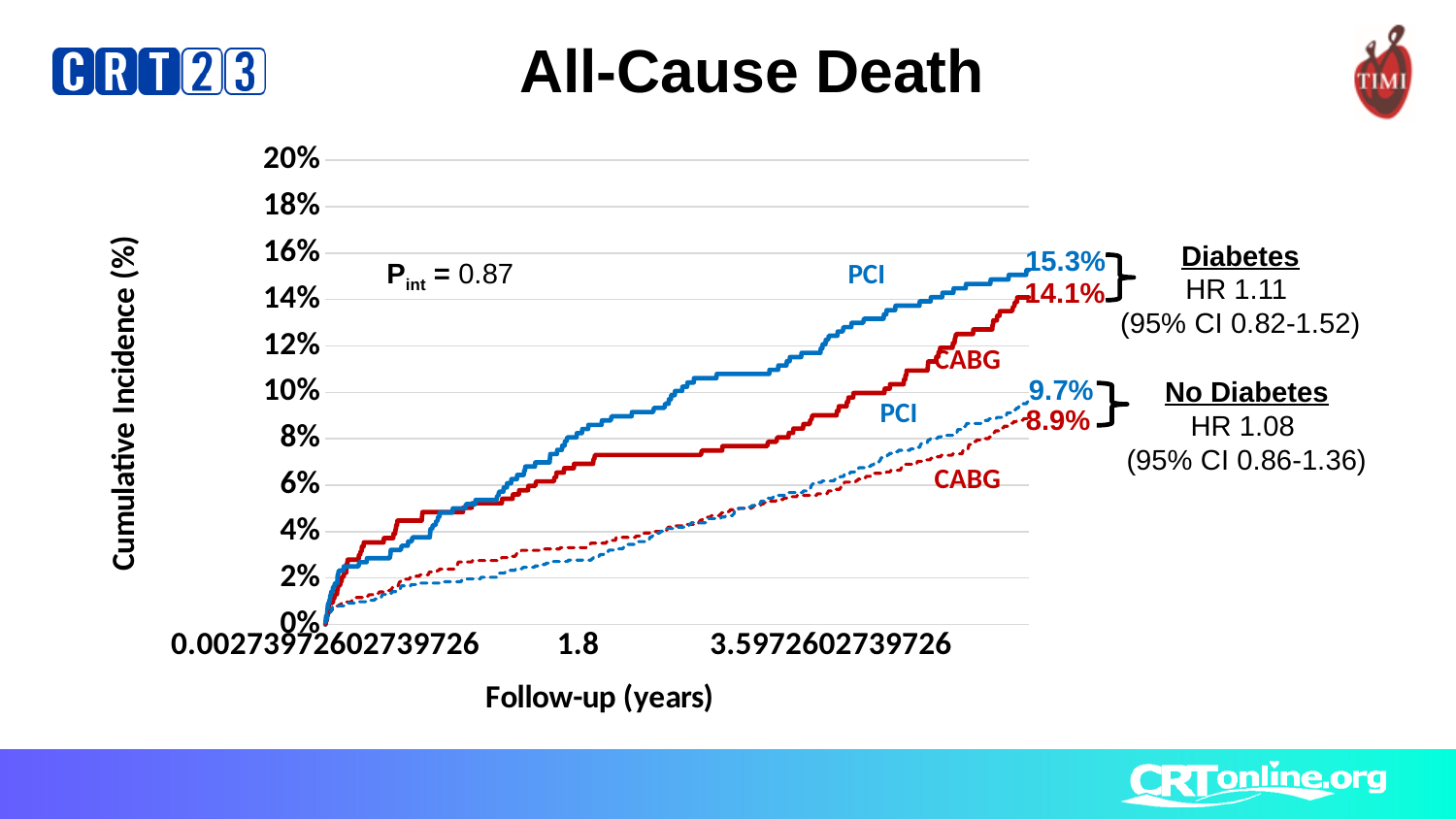
Among patients without diabetes, which has the higher final cumulative incidence, PCI or CABG? PCI What is the final cumulative incidence of all-cause death for PCI patients with diabetes? 15.3% What is the final cumulative incidence of all-cause death for PCI patients without diabetes? 9.7% What is the hazard ratio reported for the diabetes group? HR 1.11 (95% CI 0.82-1.52) Do the cumulative incidence curves rise or fall over follow-up time? Rise Which group has the highest final cumulative incidence of all-cause death? PCI with diabetes What kind of chart is shown on the slide? Line chart What is the difference between the final cumulative incidence for PCI and CABG among patients with diabetes? 1.2% Which group has the lowest final cumulative incidence of all-cause death? CABG without diabetes What is the final cumulative incidence of all-cause death for CABG patients with diabetes? 14.1% What is the difference between the final cumulative incidence for PCI and CABG among patients without diabetes? 0.8% What is the final cumulative incidence of all-cause death for CABG patients without diabetes? 8.9%